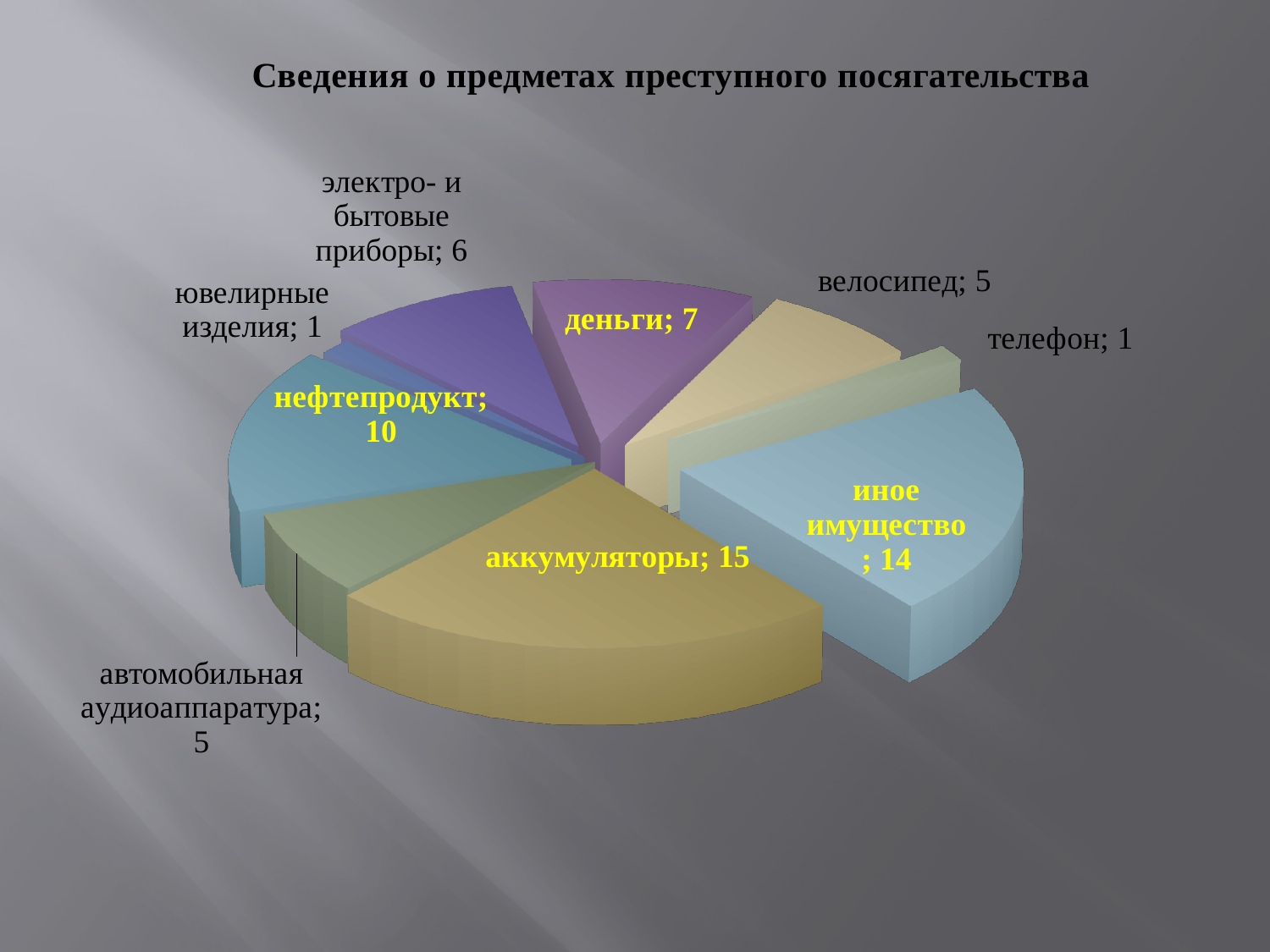
Which is larger, деньги or велосипед? деньги How many categories does the pie chart show? 9 What type of chart is shown on the slide? pie chart Which category has the highest value? аккумуляторы What is the title of the chart? Сведения о предметах преступного посягательства What is the total of all values shown in the pie chart? 64 What is the difference between the values for аккумуляторы and иное имущество? 1 What is the value for электро- и бытовые приборы? 6 What is the value for нефтепродукт? 10 What is the value for аккумуляторы? 15 What is the difference between the values for нефтепродукт and автомобильная аудиоаппаратура? 5 What is the value for иное имущество? 14